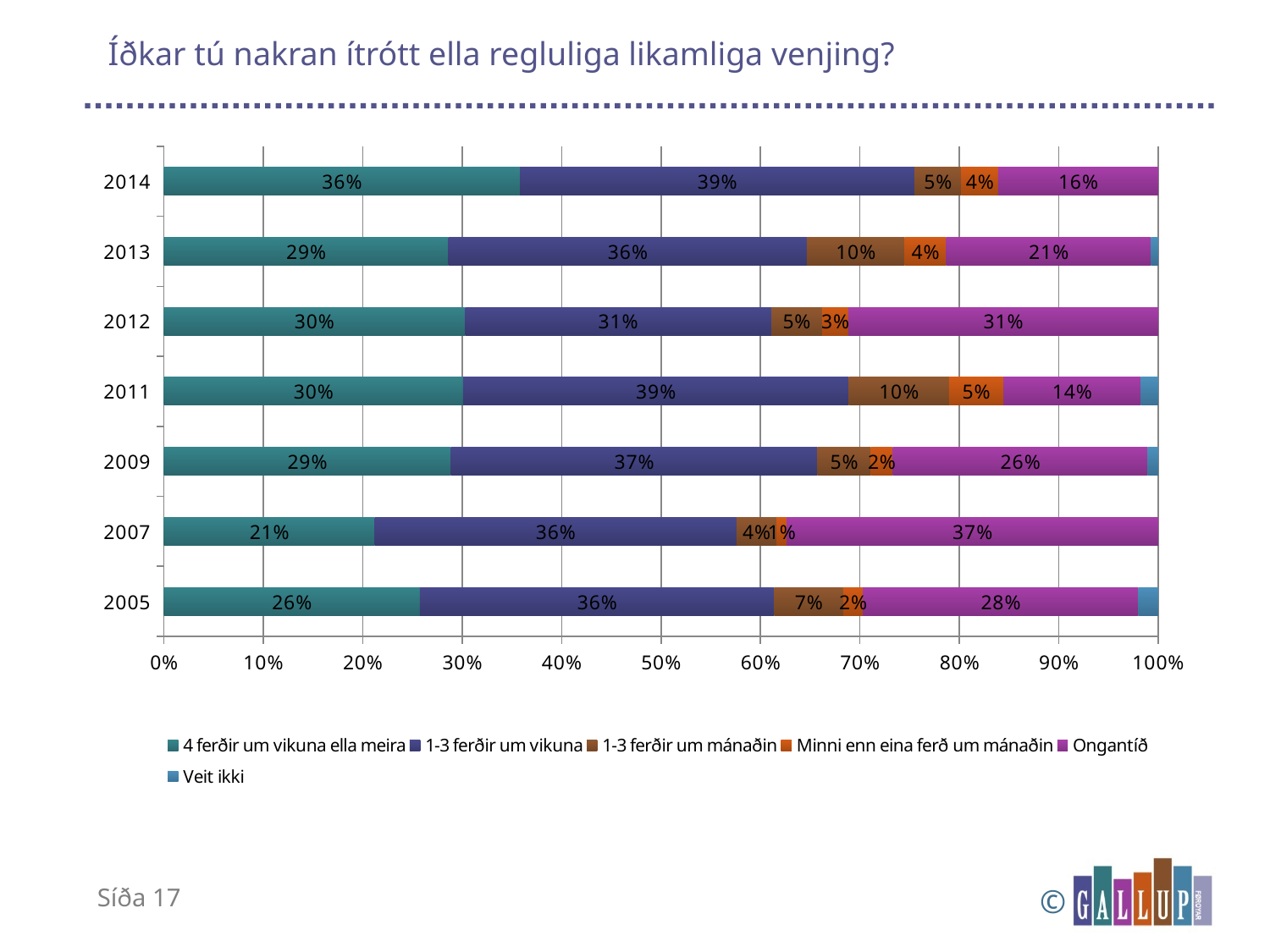
What is the value for '1-3 ferðir um mánaðin' in 2013? 10% What is the value for 'Minni enn eina ferð um mánaðin' in 2011? 5% How many series does the legend list? 6 What is the title of the chart? Íðkar tú nakran ítrótt ella regluliga likamliga venjing? What is the difference between the 'Ongantíð' values for 2012 and 2014? 15% In which year is the 'Ongantíð' segment the lowest? 2011 What kind of chart is shown on the slide? Stacked bar chart Which is larger: the '1-3 ferðir um vikuna' value in 2011 or in 2012? 2011 What percentage of respondents in 2014 answered '4 ferðir um vikuna ella meira'? 36% How many years are shown on the chart? 7 In which year is the '4 ferðir um vikuna ella meira' segment the highest? 2014 What is the value for 'Ongantíð' in 2007? 37%